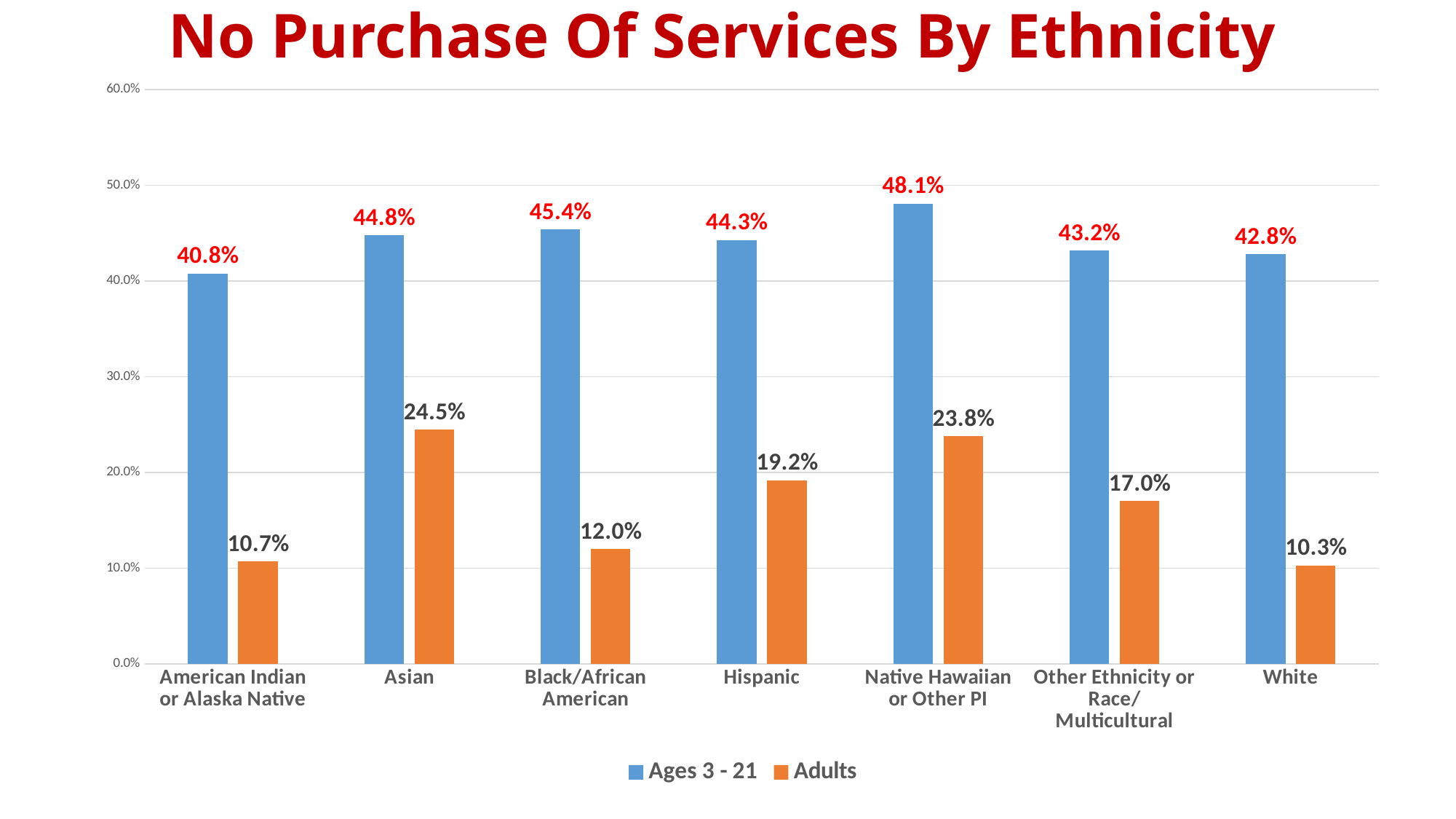
How many series does the legend list? 2 Which ethnicity has the lowest value for Adults? White What type of chart is shown on the slide? bar chart What is the value for Ages 3 - 21 for Native Hawaiian or Other PI? 48.1% Is the Adults value for Other Ethnicity or Race/Multicultural greater or less than 20.0%? less Which ethnicity has the lowest value for Ages 3 - 21? American Indian or Alaska Native What is the difference between the Ages 3 - 21 and Adults values for Hispanic? 25.1% What is the value for Adults for Asian? 24.5% What is the value for Adults for White? 10.3% Which is larger, the Adults value for Asian or the Adults value for Native Hawaiian or Other PI? Asian How many ethnicity categories are shown on the x axis? 7 Which ethnicity has the highest value for Ages 3 - 21? Native Hawaiian or Other PI